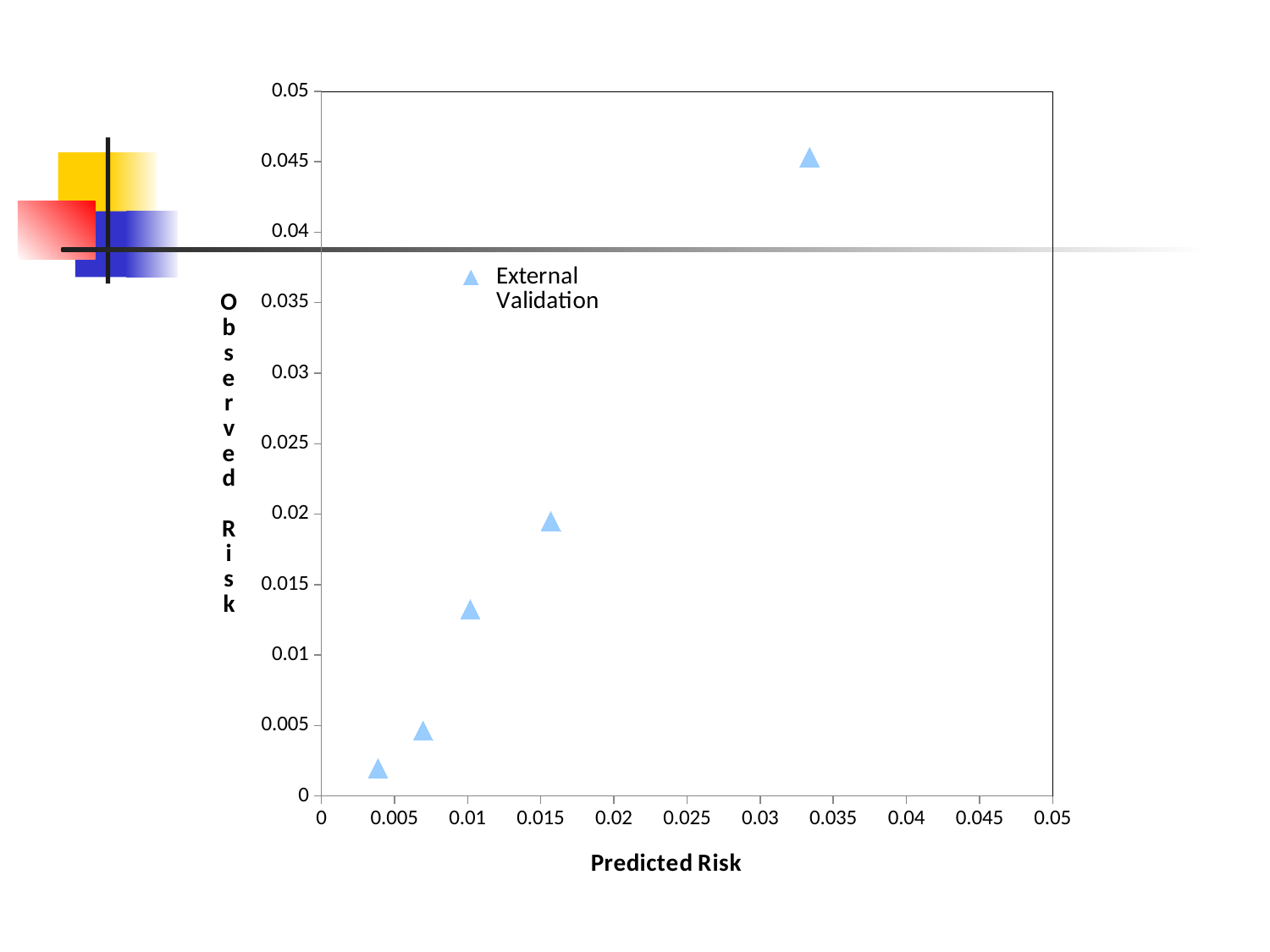
Is the observed risk of the point with the highest predicted risk greater or less than 0.04? greater How many data points are plotted in the chart? 5 What is the maximum value shown on the y axis? 0.05 Is the observed risk of the point with the lowest predicted risk greater or less than 0.005? less How many points have a predicted risk less than 0.02? 4 What kind of chart is shown on the slide? Scatter chart Does the point with the highest predicted risk also have the highest observed risk? Yes Do the observed risk values rise or fall as predicted risk increases along the x axis? Rise Is the predicted risk of the highest point greater or less than 0.03? greater What is the name of the series shown in the legend? External Validation What is the title of the x axis? Predicted Risk How many series does the legend list? 1